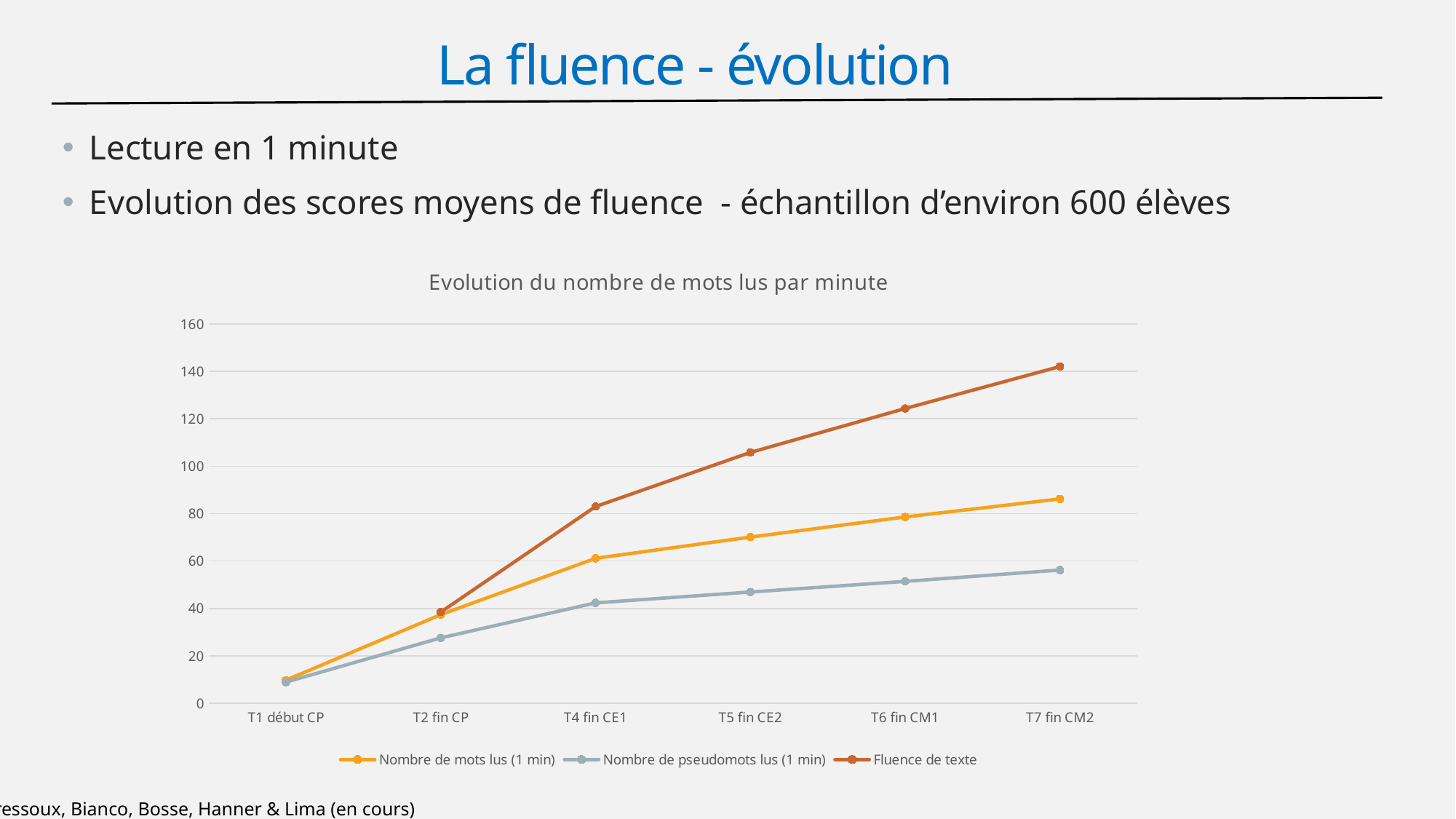
Is the value for Fluence de texte at T4 fin CE1 greater or less than 100? less Which series has the highest value at T7 fin CM2? Fluence de texte What is the title of the chart? Evolution du nombre de mots lus par minute How many time points are shown on the x axis? 6 Do the values of the Fluence de texte series rise or fall from T1 début CP to T7 fin CM2? rise Is the value for Nombre de pseudomots lus (1 min) at T7 fin CM2 greater or less than 60? less At T4 fin CE1, which is larger: Nombre de mots lus (1 min) or Nombre de pseudomots lus (1 min)? Nombre de mots lus (1 min) Is the value for Nombre de mots lus (1 min) at T7 fin CM2 greater or less than 80? greater What kind of chart is shown on the slide? line chart Which series has the lowest value at T7 fin CM2? Nombre de pseudomots lus (1 min) How many series does the legend list? 3